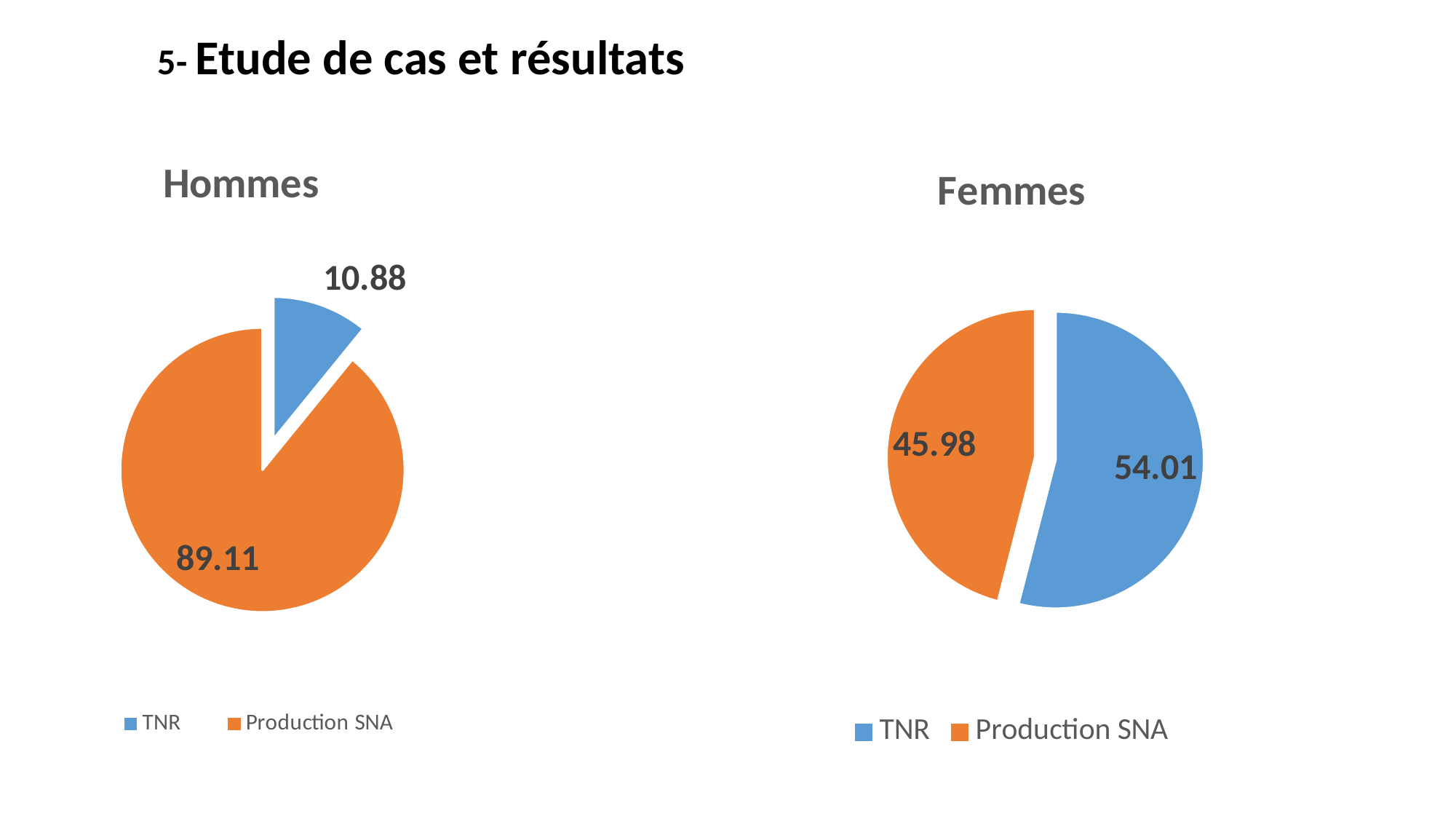
In the Hommes chart, which colour represents TNR? Blue In the Hommes chart, which slice is the largest? Production SNA Is the TNR value larger in the Hommes chart or the Femmes chart? Femmes In the Hommes chart, what is the value for TNR? 10.88 How many slices does the Femmes chart have? 2 In the Femmes chart, what is the value for Production SNA? 45.98 In the Femmes chart, what is the difference between TNR and Production SNA? 8.03 In the Femmes chart, what is the value for TNR? 54.01 In the Hommes chart, what is the value for Production SNA? 89.11 In the Hommes chart, what is the difference between Production SNA and TNR? 78.23 What type of chart is the Hommes chart? Pie chart In the Femmes chart, which slice is the smallest? Production SNA